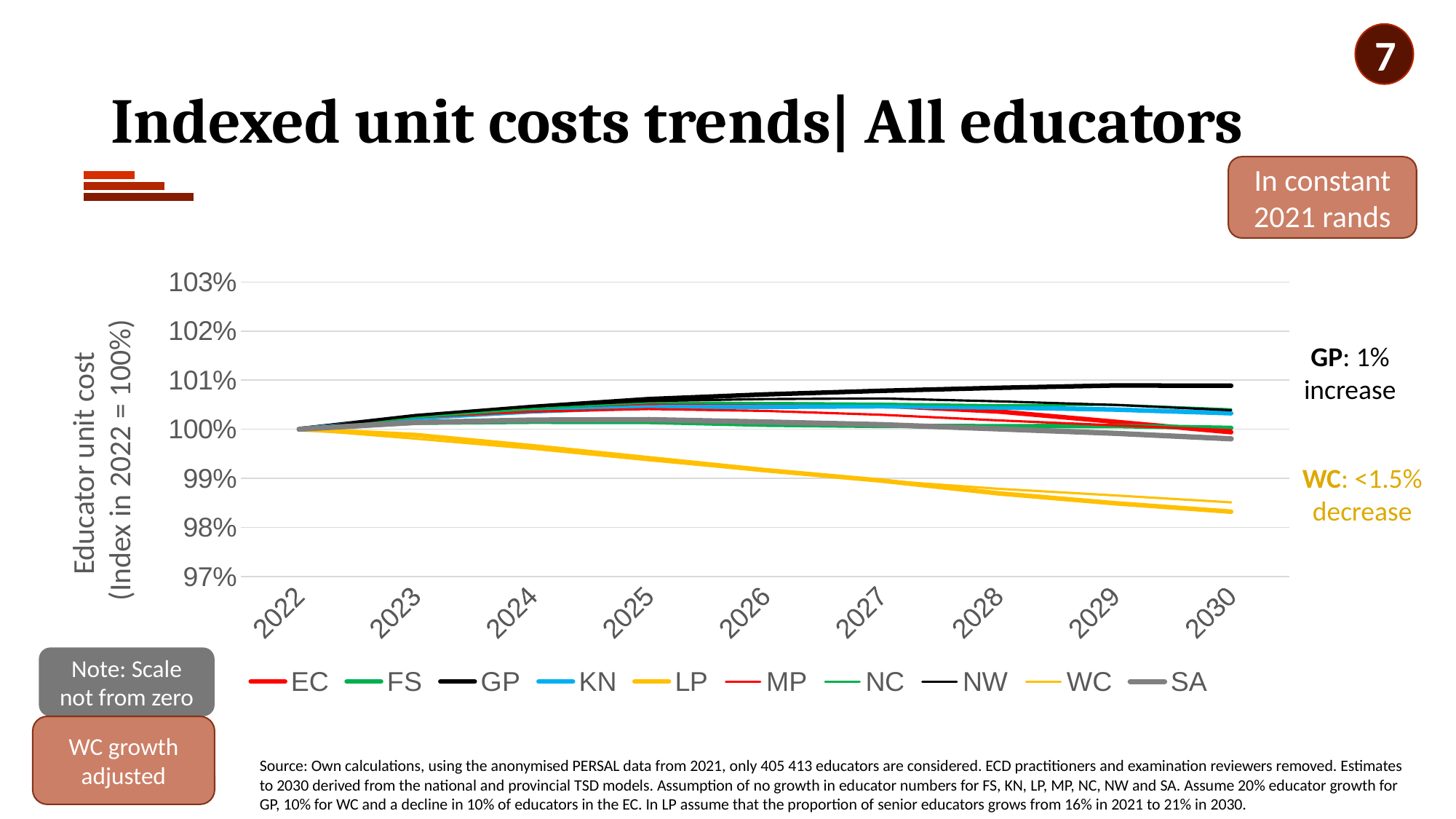
Does the LP line rise or fall from 2022 to 2030? fall In 2030, which is larger: the value for GP or the value for LP? GP Is the value for LP in 2030 greater or less than 99%? less How many series does the legend list? 10 Does the GP line rise or fall from 2022 to 2030? rise Which series has the highest indexed unit cost in 2030? GP How many years are shown along the x axis? 9 What kind of chart is shown on the slide? line chart What is the indexed unit cost value for GP in 2022? 100% Is the value for GP in 2030 greater or less than 100%? greater What is the lowest value shown on the y axis? 97% According to the annotation on the chart, what change does GP show? 1% increase